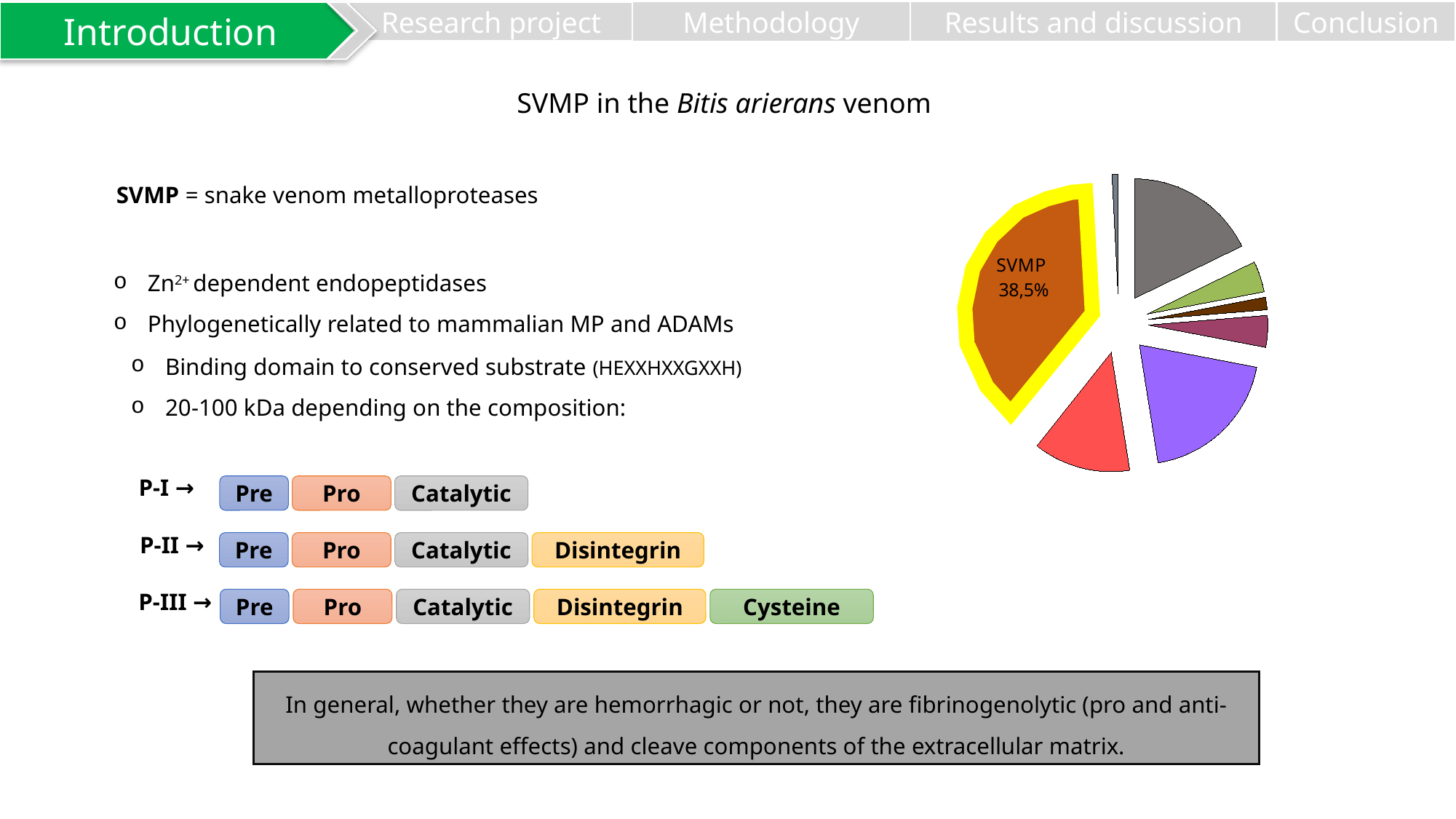
Is the SVMP slice of the pie chart greater or less than 50%? less How many slices does the pie chart have? 8 Which slice of the pie chart is labelled with a percentage? SVMP What colour outline highlights the SVMP slice in the pie chart? yellow Is the SVMP slice of the pie chart greater or less than 30%? greater Which slice of the pie chart is the largest? SVMP What share of the pie chart does the SVMP slice represent? 38,5% What kind of chart is shown on the slide? pie chart